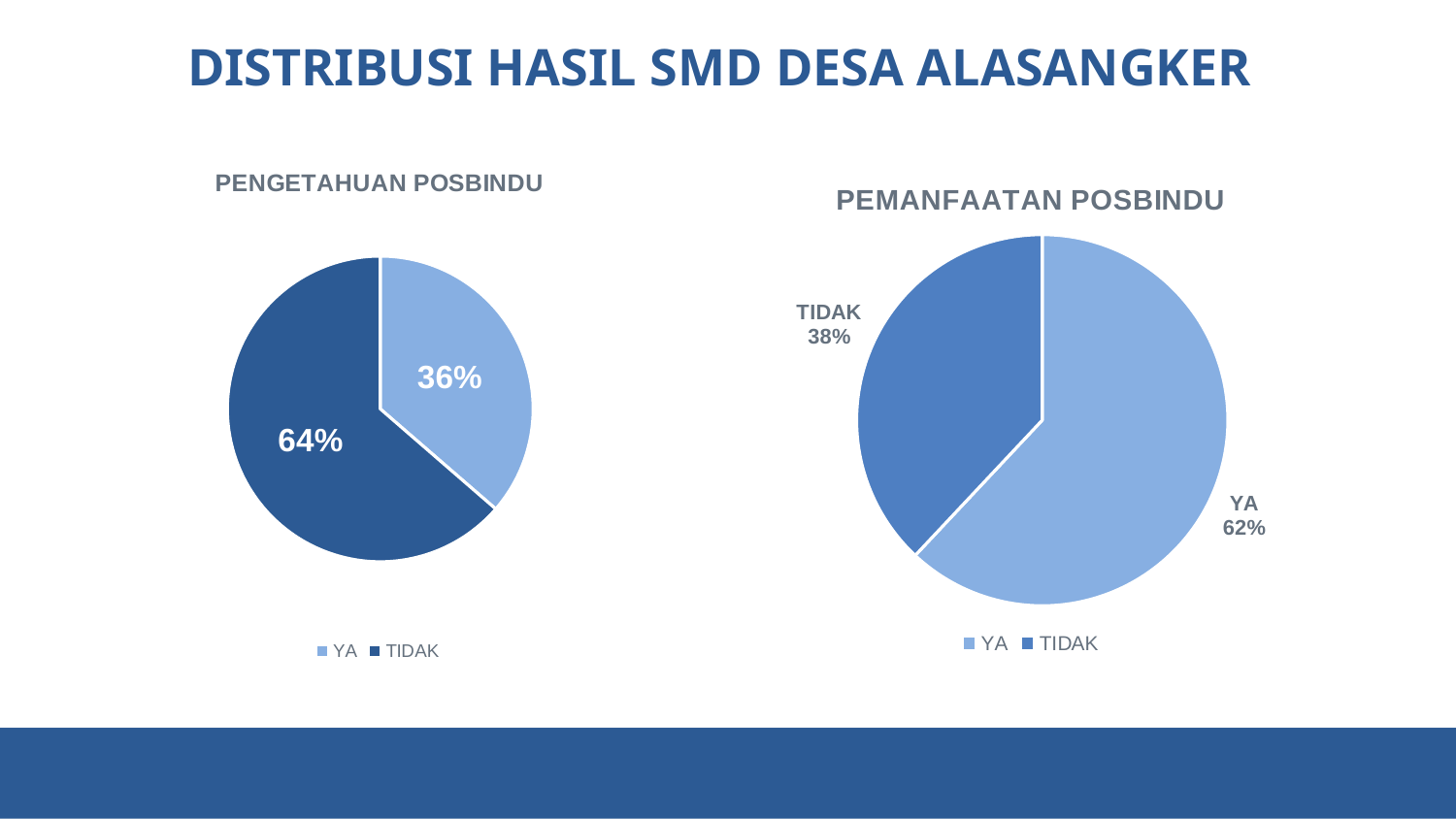
In the PENGETAHUAN POSBINDU chart, what is the difference between the TIDAK and YA shares? 28% In the PEMANFAATAN POSBINDU chart, which is larger, YA or TIDAK? YA How many slices does the PEMANFAATAN POSBINDU chart have? 2 In the PENGETAHUAN POSBINDU chart, what share of the pie is YA? 36% In the PEMANFAATAN POSBINDU chart, what share of the pie is TIDAK? 38% In the PEMANFAATAN POSBINDU chart, what is the difference between the YA and TIDAK shares? 24% What kind of chart is the PENGETAHUAN POSBINDU chart? Pie chart In the PENGETAHUAN POSBINDU chart, what share of the pie is TIDAK? 64% What entries does the legend of the PENGETAHUAN POSBINDU chart list? YA, TIDAK In the PENGETAHUAN POSBINDU chart, which slice is the largest? TIDAK In the PEMANFAATAN POSBINDU chart, which slice is the smallest? TIDAK